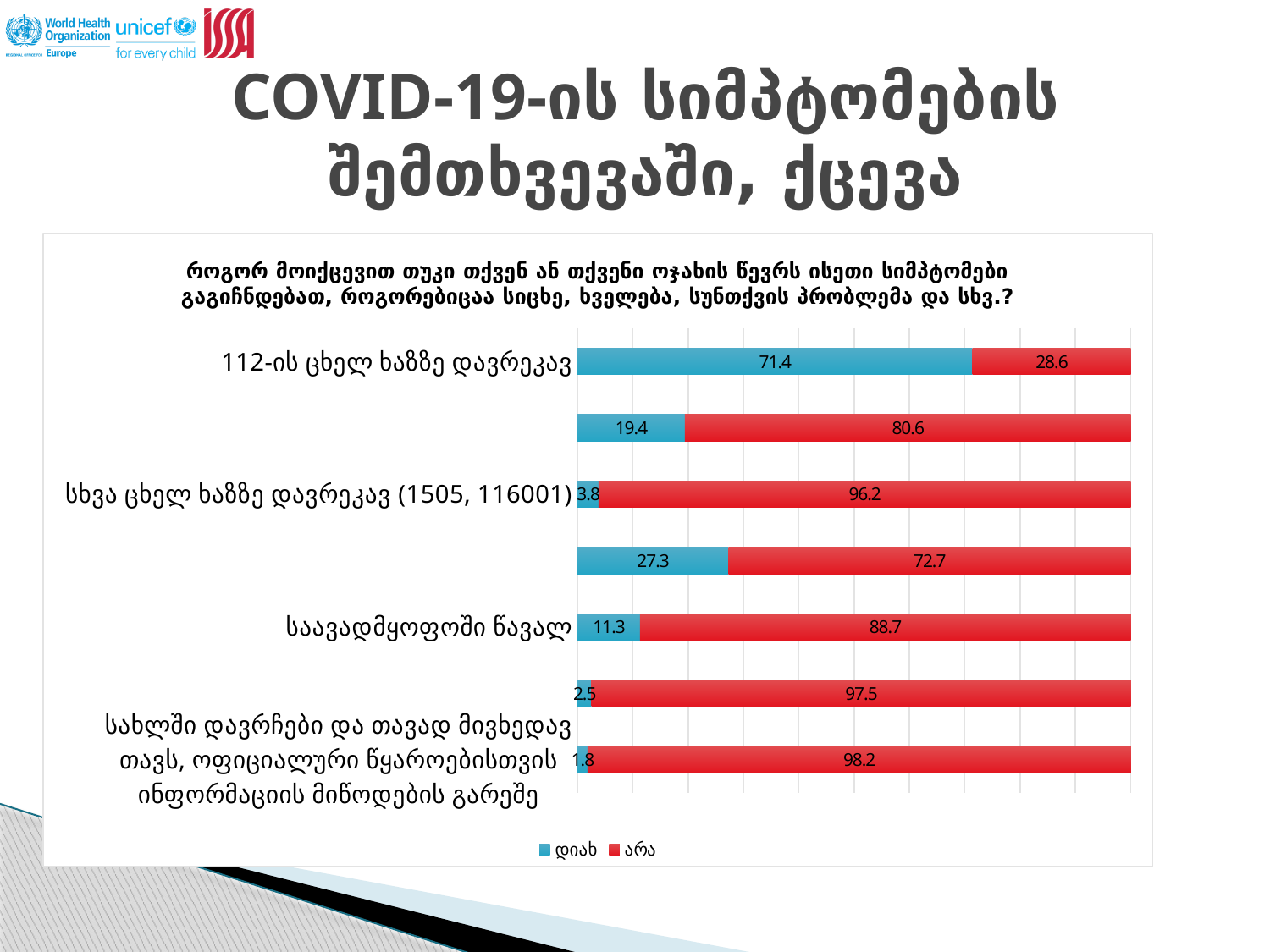
What is the value of the არა series for the category "112-ის ცხელ ხაზზე დავრეკავ"? 28.6 Which category has the highest დიახ value? 112-ის ცხელ ხაზზე დავრეკავ What is the არა value for "საავადმყოფოში წავალ"? 88.7 What is the დიახ value for "სხვა ცხელ ხაზზე დავრეკავ (1505, 116001)"? 3.8 What is the difference between the დიახ and არა values for "112-ის ცხელ ხაზზე დავრეკავ"? 42.8 Which category has the lowest დიახ value? სახლში დავრჩები და თავად მივხედავ თავს, ოფიციალური წყაროებისთვის ინფორმაციის მიწოდების გარეშე What is the დიახ value for "სახლში დავრჩები და თავად მივხედავ თავს, ოფიციალური წყაროებისთვის ინფორმაციის მიწოდების გარეშე"? 1.8 What kind of chart is shown on the slide? Stacked bar chart Which has a larger დიახ value: "112-ის ცხელ ხაზზე დავრეკავ" or "საავადმყოფოში წავალ"? 112-ის ცხელ ხაზზე დავრეკავ How many bars are plotted in the chart? 7 How many series does the legend list? 2 What is the value of the დიახ series for the category "112-ის ცხელ ხაზზე დავრეკავ"? 71.4